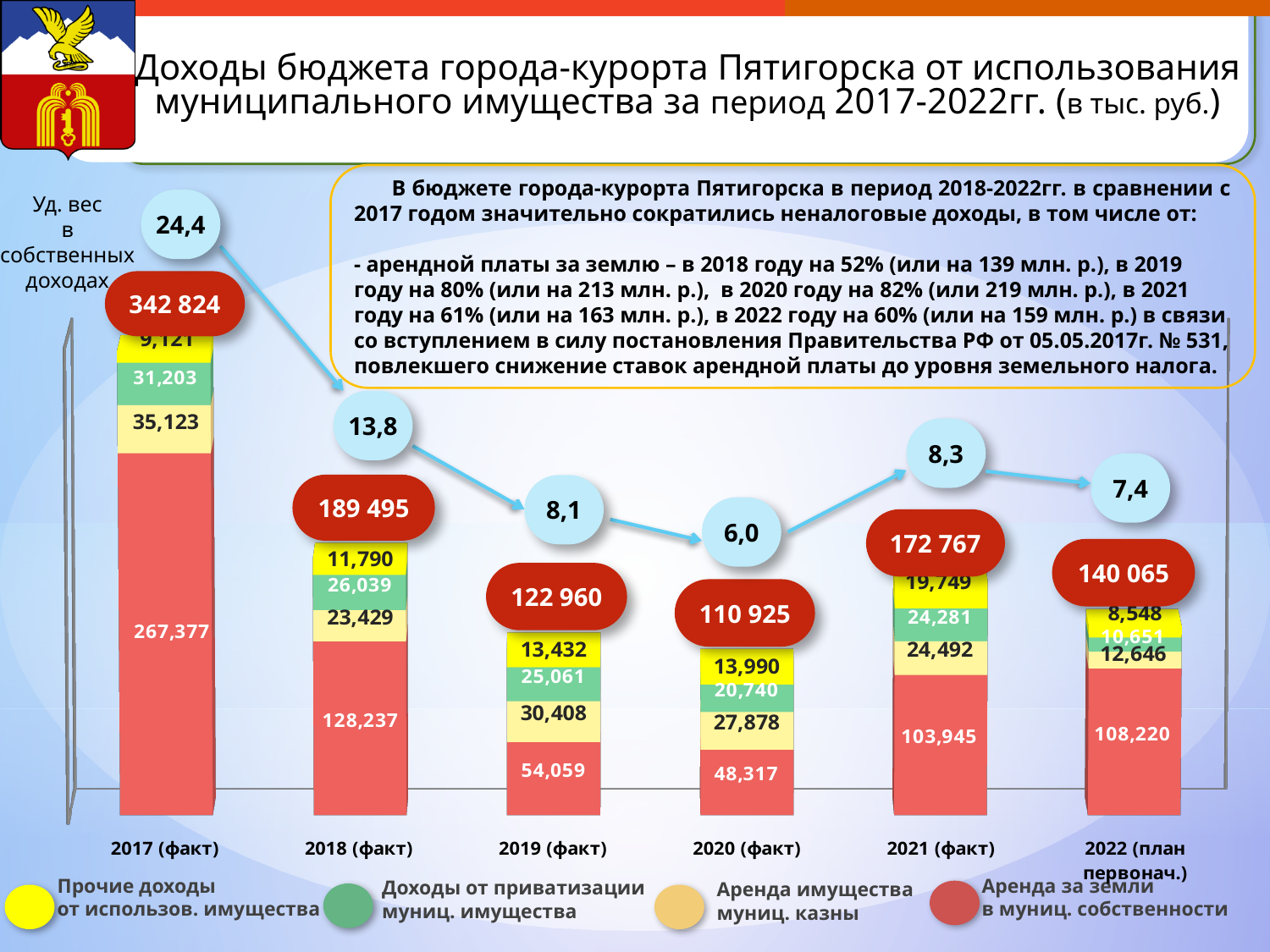
What is the value for 'Аренда за земли в муниц. собственности' in 2019 (факт)? 54,059 Which year has the larger value for 'Доходы от приватизации муниц. имущества': 2018 (факт) or 2019 (факт)? 2018 (факт) What colour represents 'Аренда за земли в муниц. собственности' in the legend? red What is the share in own revenues ('Уд. вес в собственных доходах') shown for 2020 (факт)? 6,0 In which year is the value for 'Аренда за земли в муниц. собственности' the highest? 2017 (факт) What kind of chart is shown on the slide? stacked bar chart Does the share in own revenues ('Уд. вес в собственных доходах') rise or fall from 2017 to 2020? fall What is the total shown in the red oval for 2021 (факт)? 172 767 What is the difference between the 'Аренда за земли в муниц. собственности' values for 2017 (факт) and 2018 (факт)? 139,140 How many years (categories) are shown along the x axis of the chart? 6 How many series does the legend of the chart list? 4 Which year has the lowest total income from use of municipal property? 2020 (факт)